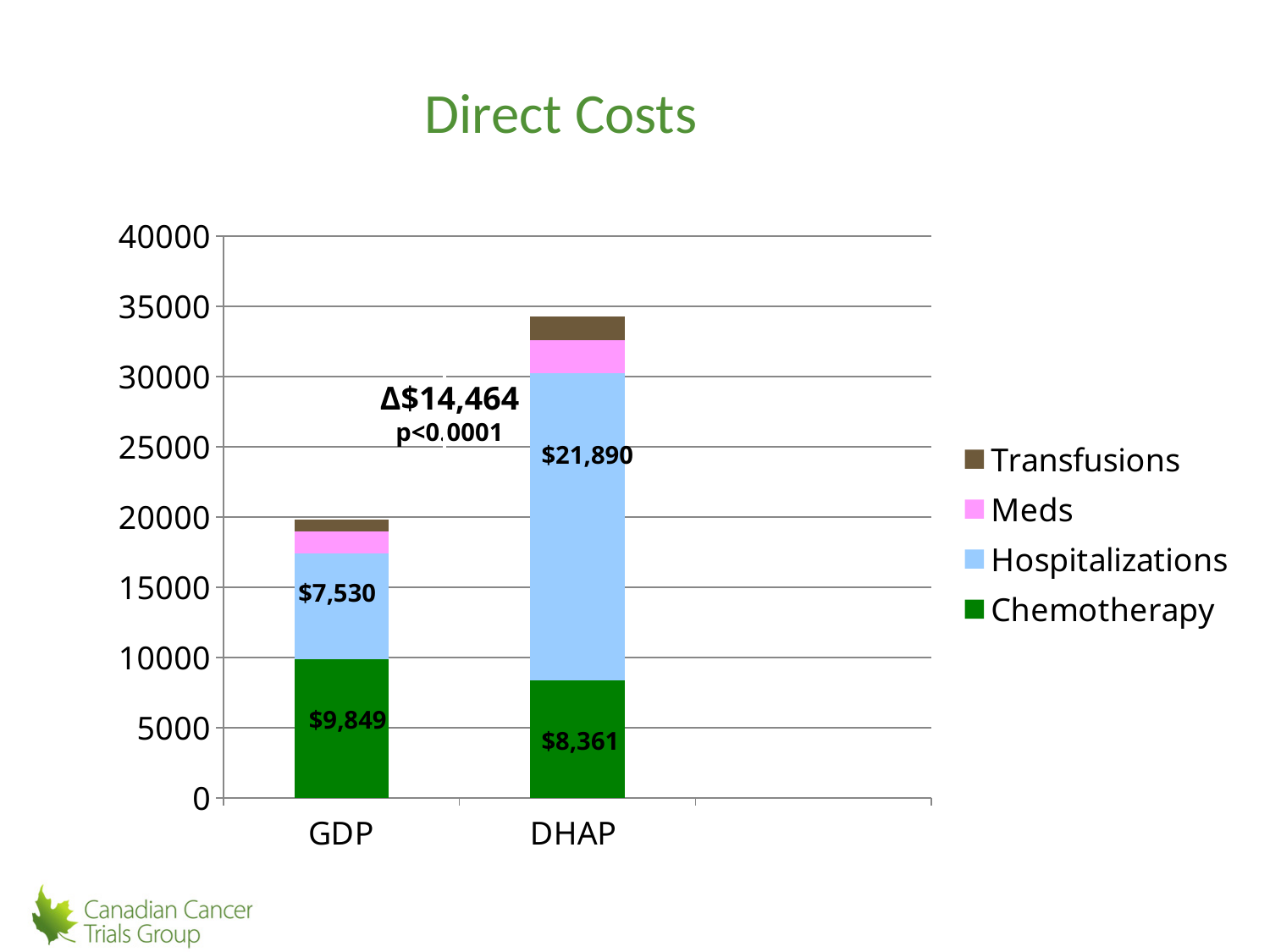
What is the Hospitalizations cost for DHAP? $21,890 What is the difference in Chemotherapy cost between GDP and DHAP? $1,488 Is the total direct cost for DHAP greater or less than 30000? greater How many series does the legend list? 4 What is the difference in Hospitalizations cost between DHAP and GDP? $14,360 What type of chart is shown on the slide? Stacked bar chart What is the Hospitalizations cost for GDP? $7,530 Which treatment has the higher Hospitalizations cost, GDP or DHAP? DHAP What is the Chemotherapy cost for DHAP? $8,361 Which treatment has the higher Chemotherapy cost, GDP or DHAP? GDP What is the Chemotherapy cost for GDP? $9,849